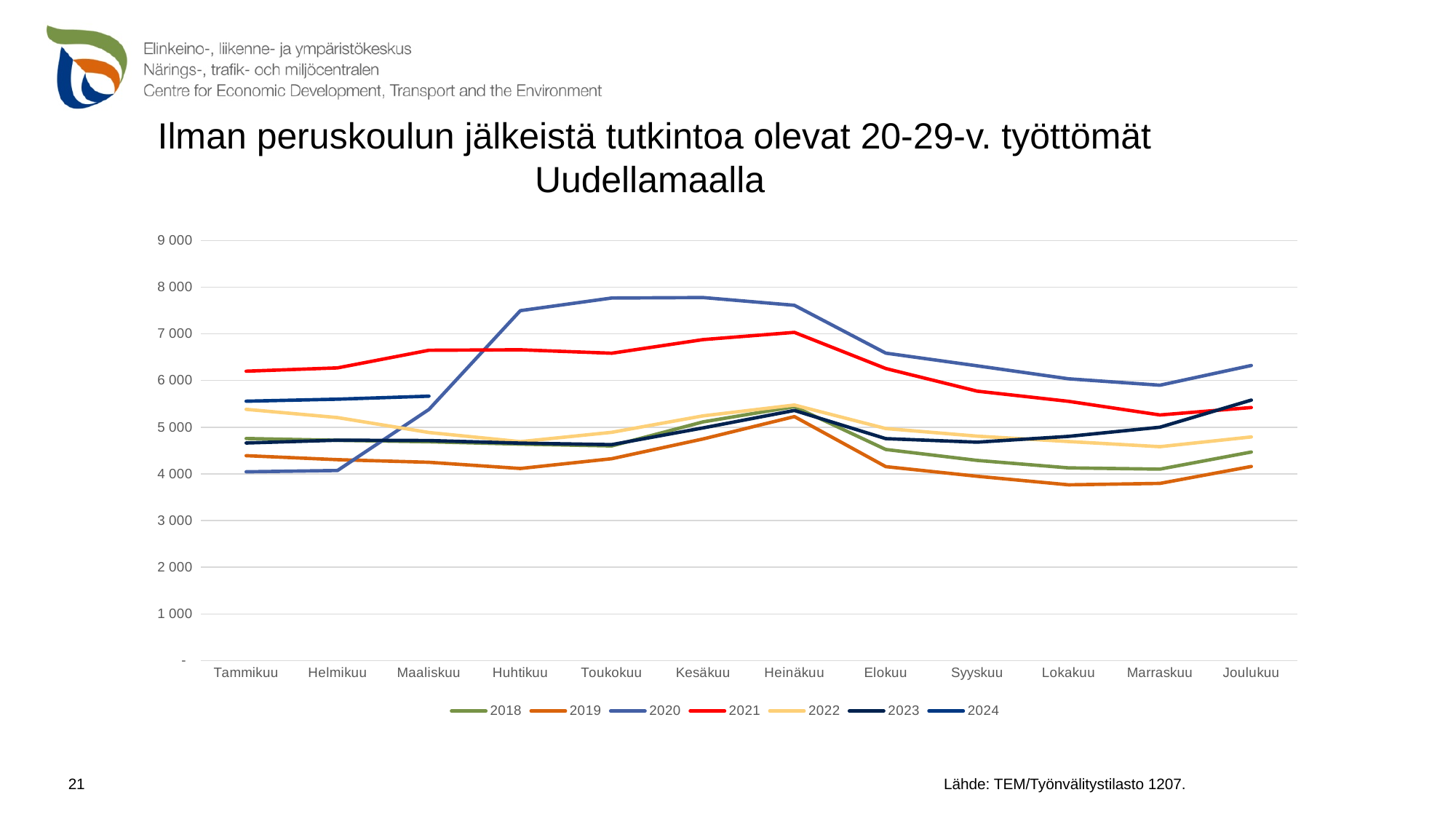
In which month does the 2024 line end? Maaliskuu Which series has the lowest value in Lokakuu? 2019 Does the 2020 line rise or fall from Tammikuu to Toukokuu? rise Which series has the highest value in Kesäkuu? 2020 Is the value for 2024 in Tammikuu greater or less than 5 000? greater How many months are shown along the x axis? 12 Is the value for 2018 in Elokuu greater or less than 5 000? less Is the value for 2020 in Kesäkuu greater or less than 7 000? greater How many series does the legend list? 7 What kind of chart is shown on the slide? line chart In Heinäkuu, which is higher: the 2020 line or the 2021 line? 2020